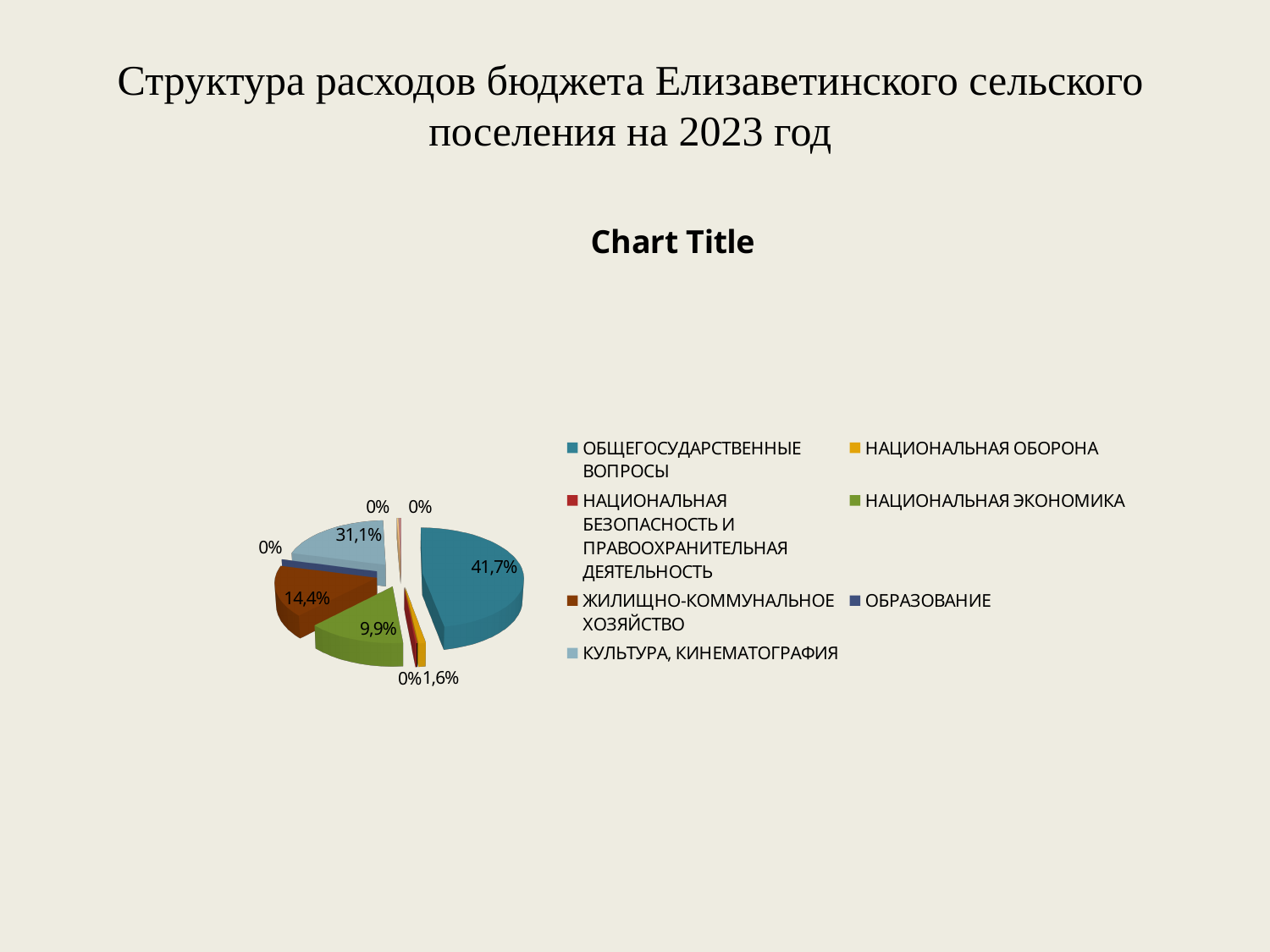
How many categories does the legend list? 7 Which is larger: the share for ЖИЛИЩНО-КОММУНАЛЬНОЕ ХОЗЯЙСТВО or for НАЦИОНАЛЬНАЯ ЭКОНОМИКА? ЖИЛИЩНО-КОММУНАЛЬНОЕ ХОЗЯЙСТВО What share of the budget goes to КУЛЬТУРА, КИНЕМАТОГРАФИЯ? 31,1% Which category has the largest share of the budget? ОБЩЕГОСУДАРСТВЕННЫЕ ВОПРОСЫ What share of the budget goes to ЖИЛИЩНО-КОММУНАЛЬНОЕ ХОЗЯЙСТВО? 14,4% What kind of chart is shown on the slide? Pie chart What share of the budget goes to ОБРАЗОВАНИЕ? 0% What share of the budget goes to НАЦИОНАЛЬНАЯ ЭКОНОМИКА? 9,9% What share of the budget goes to ОБЩЕГОСУДАРСТВЕННЫЕ ВОПРОСЫ? 41,7% What is the title shown directly above the pie chart? Chart Title What share of the budget goes to НАЦИОНАЛЬНАЯ ОБОРОНА? 1,6% By how many percentage points does the share for ОБЩЕГОСУДАРСТВЕННЫЕ ВОПРОСЫ exceed the share for КУЛЬТУРА, КИНЕМАТОГРАФИЯ? 10,6%